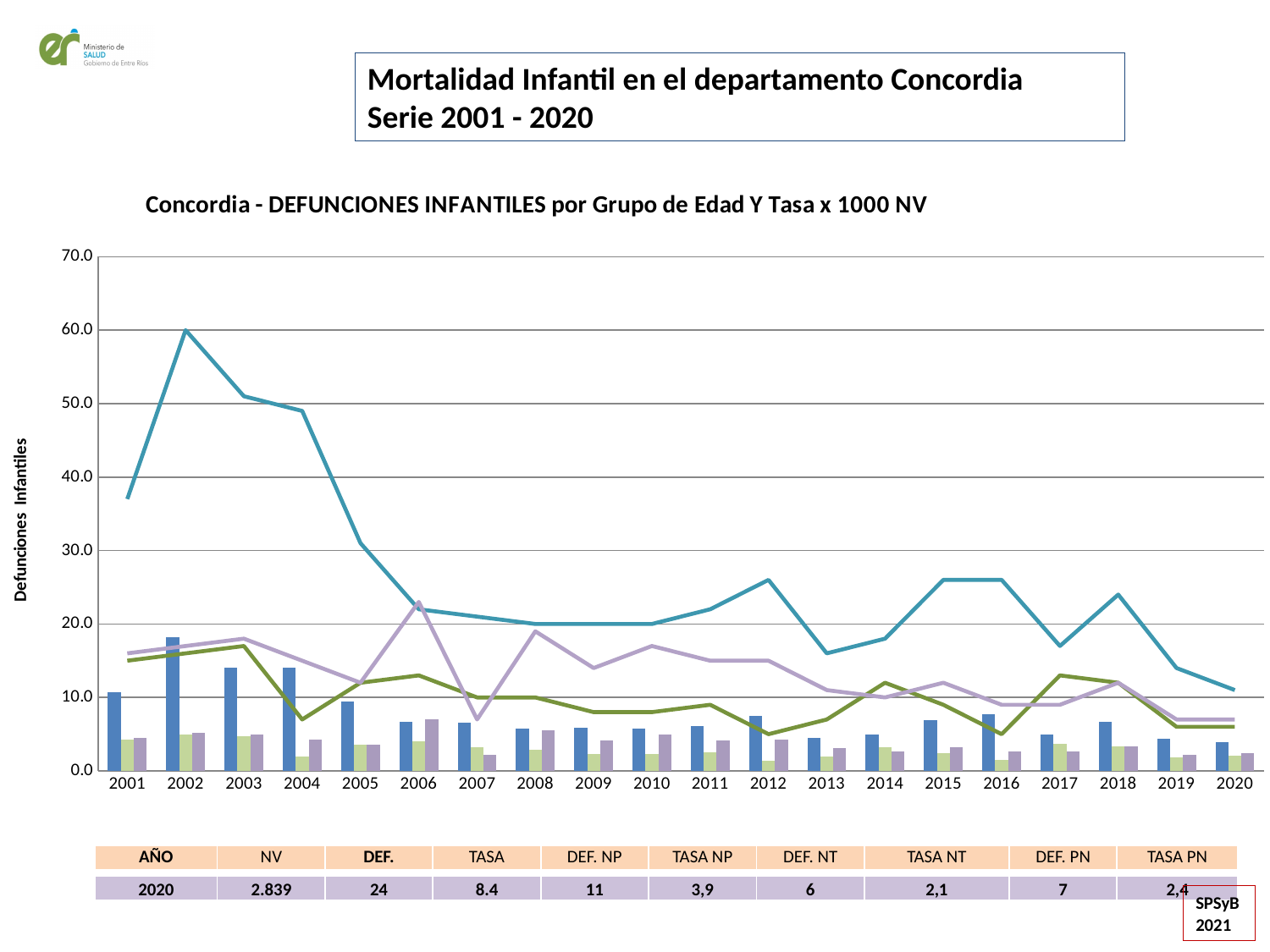
Does the teal line rise or fall between 2002 and 2005? It falls In which year is the blue bar the tallest? 2002 Is the value of the teal line in 2001 greater or less than 30? greater In which year does the teal line reach its highest value? 2002 How many years are shown along the x axis of the chart? 20 What is the title of the chart? Concordia - DEFUNCIONES INFANTILES por Grupo de Edad Y Tasa x 1000 NV Is the value of the teal line in 2013 greater or less than 20? less In which year does the teal line reach its lowest value? 2020 What kind of chart is shown on the slide? A combined bar and line chart What is the label on the vertical axis of the chart? Defunciones Infantiles Which year has the taller blue bar, 2002 or 2020? 2002 Is the value of the teal line in 2002 greater or less than 50? greater